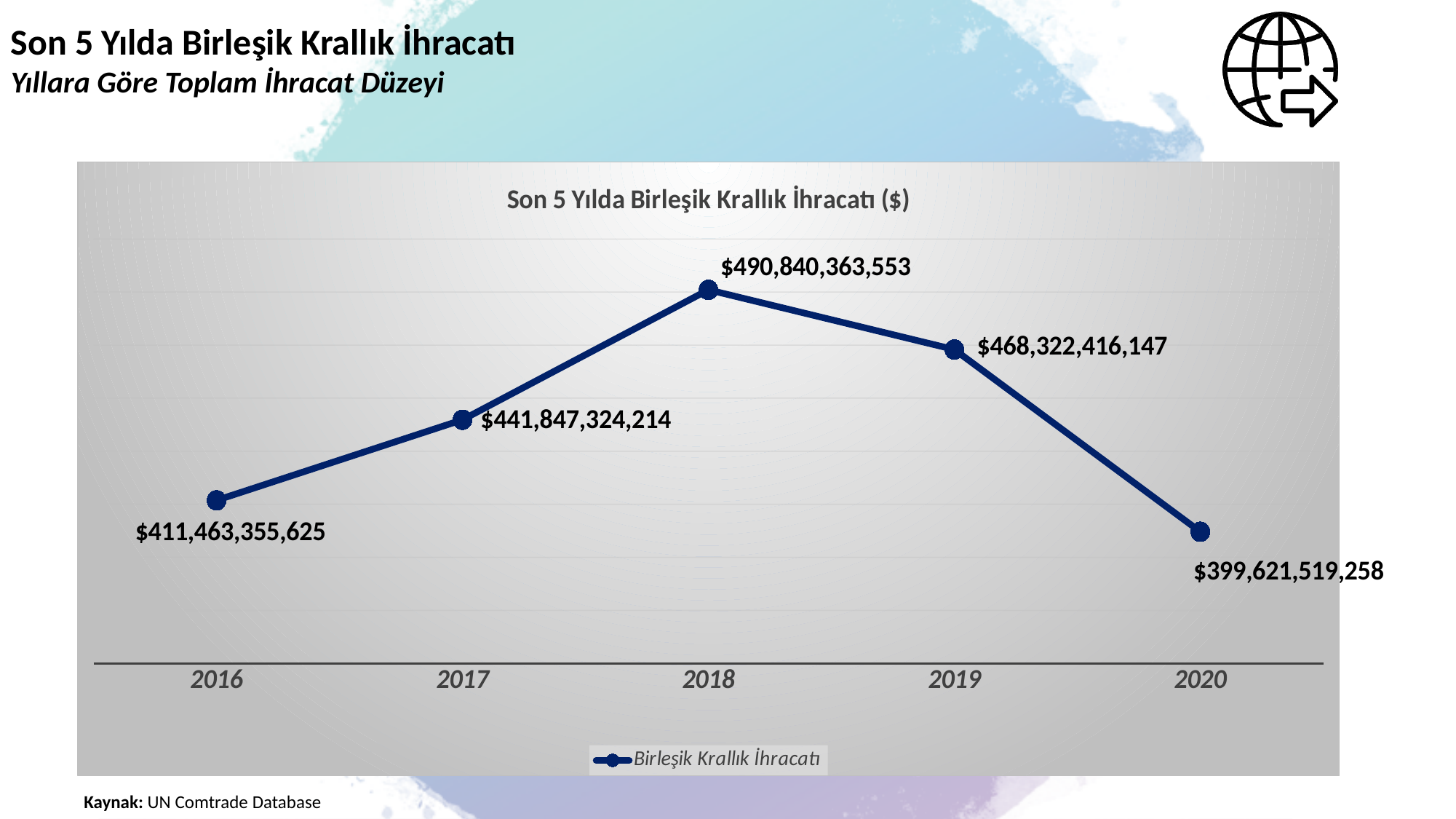
What kind of chart is shown? line chart Which is larger, the value for 2017 or the value for 2019? 2019 What is the value for 2016? $411,463,355,625 What is the value for 2020? $399,621,519,258 What is the value for 2018? $490,840,363,553 Which year has the lowest value? 2020 What is the difference between the values for 2018 and 2019? $22,517,947,406 Which year has the highest value? 2018 What is the difference between the values for 2017 and 2016? $30,383,968,589 Do the values rise or fall from 2018 to 2020? fall How many series does the legend list? 1 How many years are plotted on the chart? 5